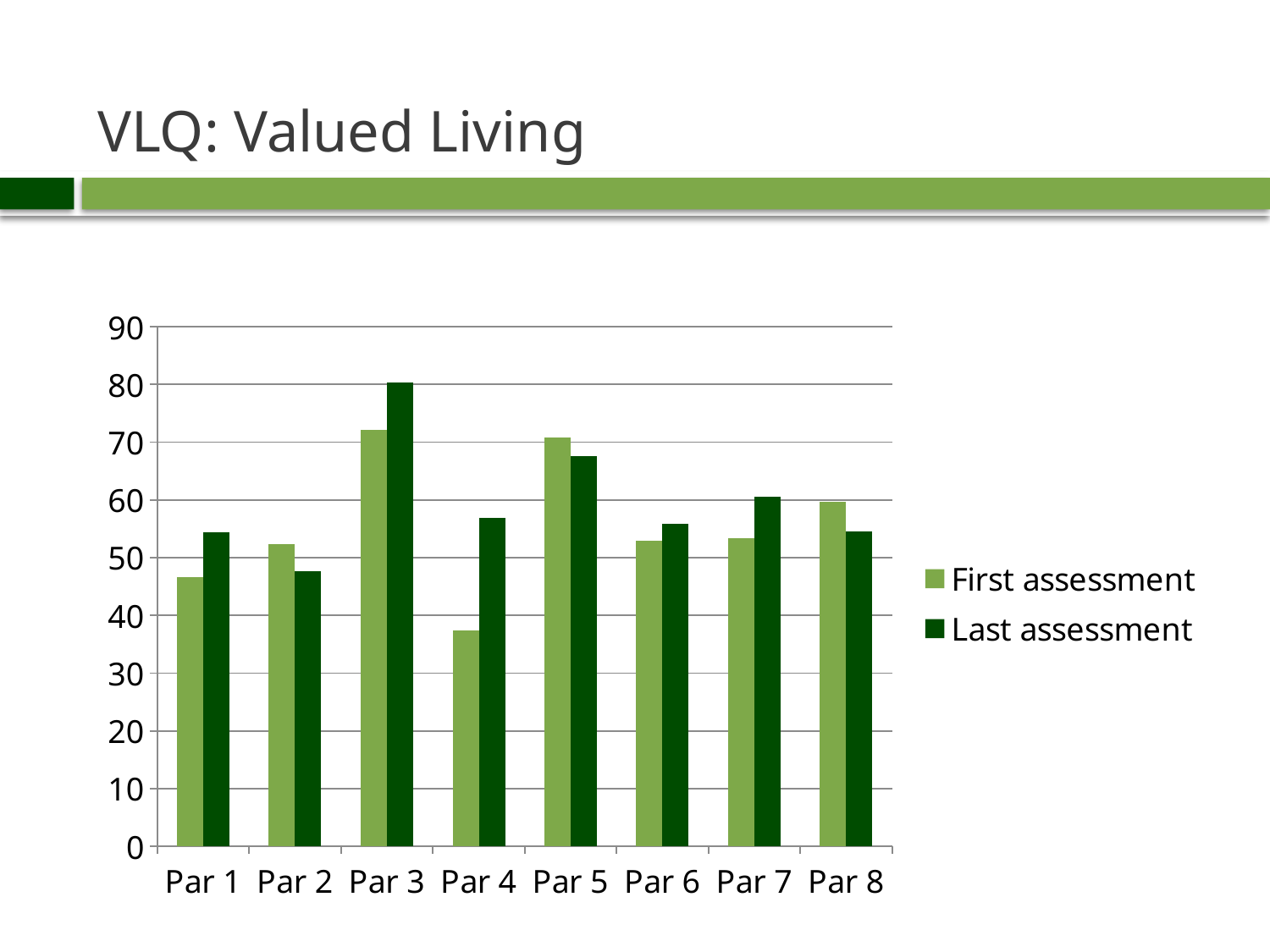
What kind of chart is shown on the slide? bar chart How many participants (categories) are shown on the x axis? 8 For Par 8, which is larger: the First assessment or the Last assessment? First assessment What is the title of the slide containing the chart? VLQ: Valued Living Which participant has the highest Last assessment value? Par 3 Which participant has the lowest First assessment value? Par 4 For Par 2, which is larger: the First assessment or the Last assessment? First assessment How many series does the legend list? 2 Is the First assessment value for Par 4 greater or less than 40? less For Par 4, which is larger: the First assessment or the Last assessment? Last assessment Which participant has the lowest Last assessment value? Par 2 Is the Last assessment value for Par 3 greater or less than 70? greater